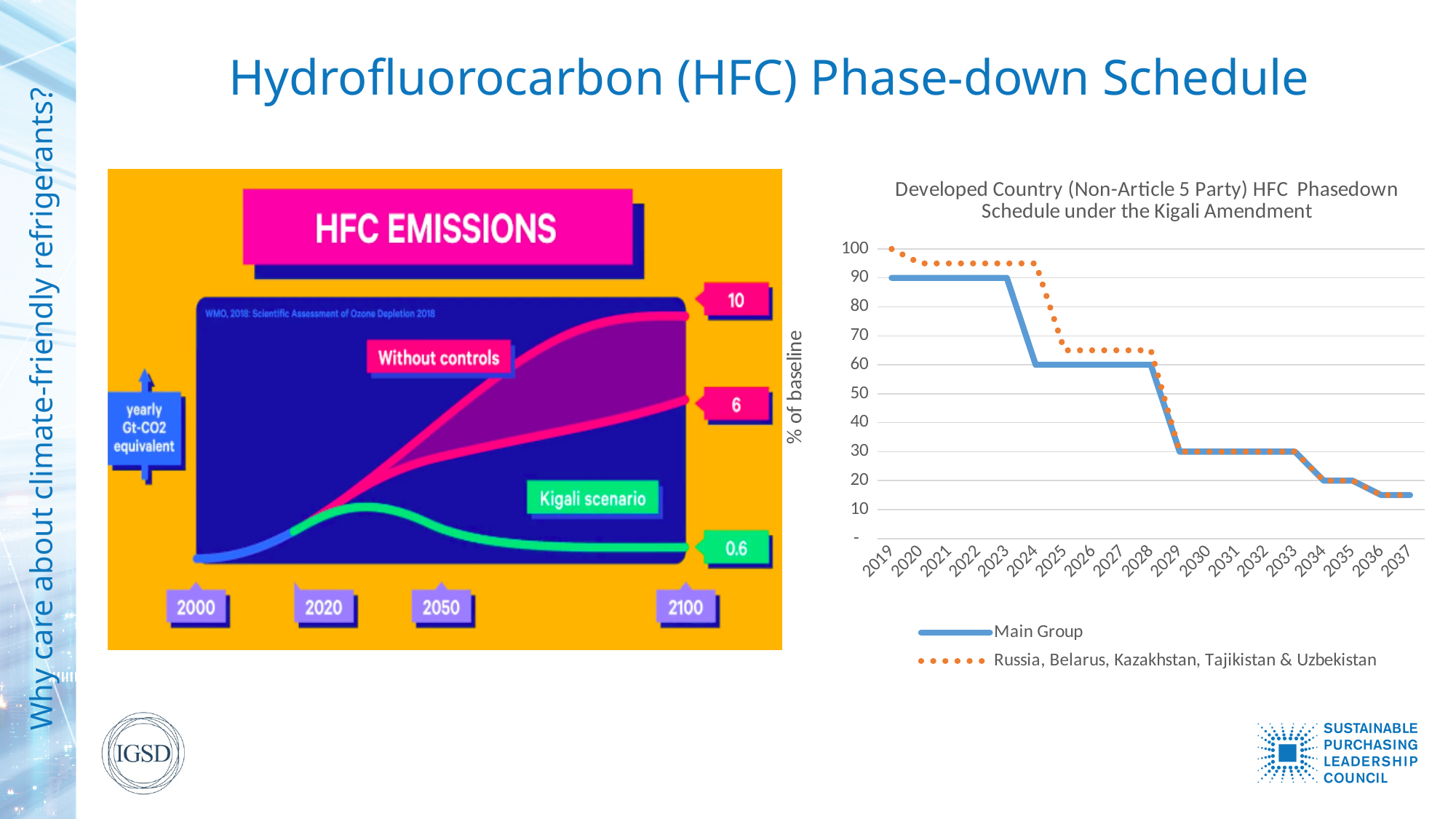
On the right chart (Developed Country HFC Phasedown Schedule), how many series does the legend list? 2 On the right chart (Developed Country HFC Phasedown Schedule), do the values rise or fall from 2019 to 2037? Fall On the left chart (HFC EMISSIONS), what value does the 'Without controls' line reach at 2100? 10 On the right chart (Developed Country HFC Phasedown Schedule), how many years are shown on the x axis? 19 On the right chart (Developed Country HFC Phasedown Schedule), in 2025, which series has the larger value: Main Group or Russia, Belarus, Kazakhstan, Tajikistan & Uzbekistan? Russia, Belarus, Kazakhstan, Tajikistan & Uzbekistan On the left chart (HFC EMISSIONS), what value does the 'Kigali scenario' line reach at 2100? 0.6 On the right chart (Developed Country HFC Phasedown Schedule), what is the y-axis label? % of baseline On the right chart (Developed Country HFC Phasedown Schedule), what is the value for Russia, Belarus, Kazakhstan, Tajikistan & Uzbekistan in 2019? 100 On the right chart (Developed Country HFC Phasedown Schedule), what is the Main Group value in 2024? 60 On the right chart (Developed Country HFC Phasedown Schedule), what kind of chart is it? Line chart On the right chart (Developed Country HFC Phasedown Schedule), what is the Main Group value in 2019? 90 On the right chart (Developed Country HFC Phasedown Schedule), is the value for Russia, Belarus, Kazakhstan, Tajikistan & Uzbekistan in 2026 greater or less than 60? greater